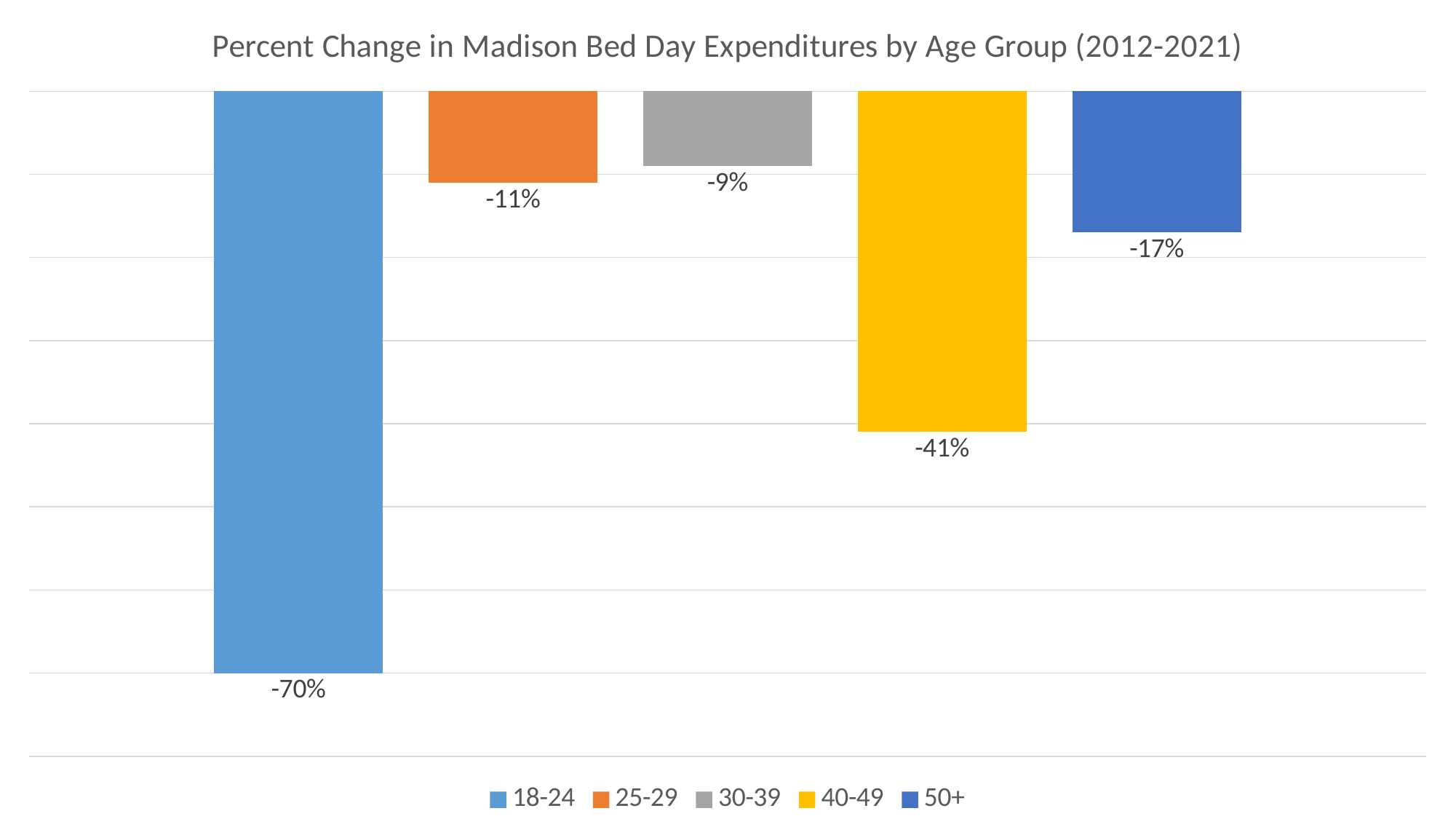
Which age group had a larger decline, 25-29 or 50+? 50+ What is the percent change in bed day expenditures for the 50+ age group? -17% What is the title of the chart? Percent Change in Madison Bed Day Expenditures by Age Group (2012-2021) What is the percent change in bed day expenditures for the 40-49 age group? -41% How many age groups are shown in the chart? 5 Which age group shows the smallest decline in bed day expenditures? 30-39 Which age group shows the largest decline in bed day expenditures? 18-24 What is the percent change in bed day expenditures for the 18-24 age group? -70% What is the difference between the percent change for the 18-24 group and the 40-49 group? 29 percentage points What type of chart is shown on the slide? Bar chart How many entries does the legend list? 5 What is the percent change in bed day expenditures for the 30-39 age group? -9%